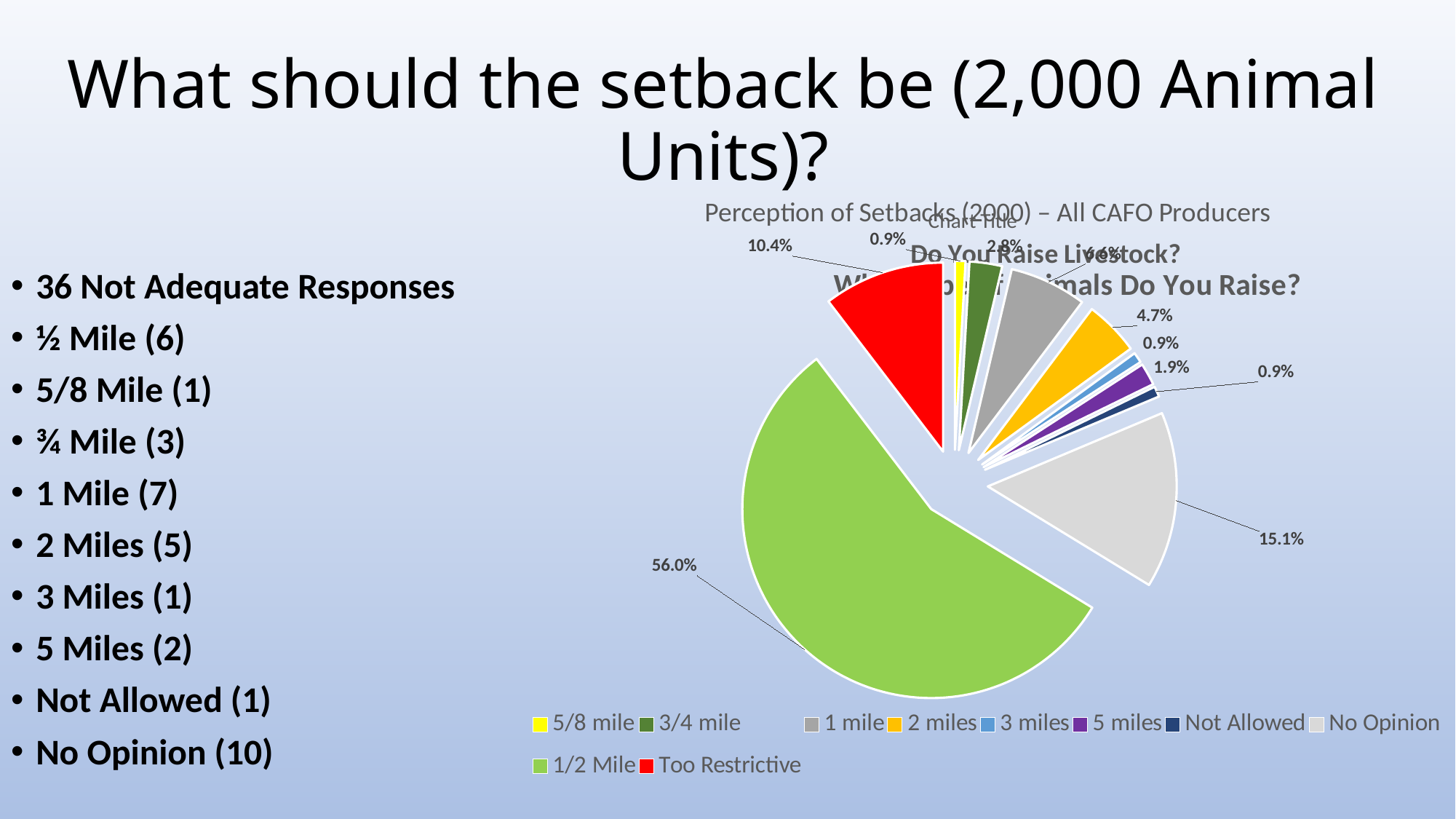
How many percentage points larger is the 1/2 Mile slice than the No Opinion slice? 40.9 percentage points What percentage is shown for the 5 miles slice? 1.9% What percentage is shown for the 2 miles slice? 4.7% What percentage is shown for the 3/4 mile slice? 2.8% How many categories does the chart legend list? 10 What percentage of the pie does the 1/2 Mile slice represent? 56.0% How many percentage points larger is the Too Restrictive slice than the 2 miles slice? 5.7 percentage points What type of chart is shown on the slide? Pie chart What percentage is shown for the Too Restrictive slice? 10.4% Which category has the largest slice of the pie? 1/2 Mile What percentage is shown for the No Opinion slice? 15.1% Which slice is larger, No Opinion or Too Restrictive? No Opinion